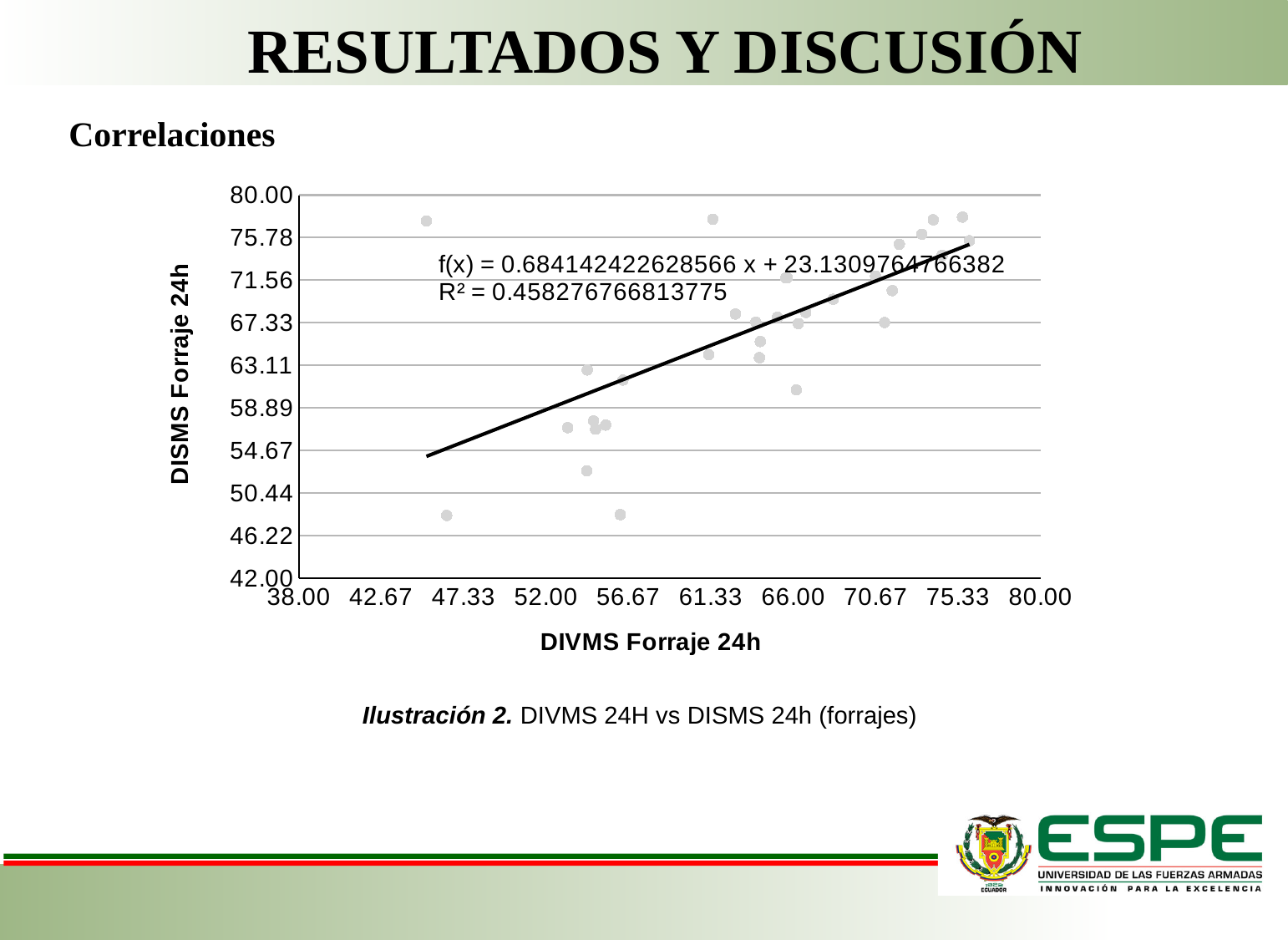
Does the trend line in the chart rise or fall as DIVMS Forraje 24h increases? Rises What is the highest value shown on the x axis? 80.00 What is the highest value shown on the y axis? 80.00 Is the slope of the trend line greater or less than 1? less What kind of chart is shown on the slide? Scatter chart Is the R² value of the trend line greater or less than 0.5? less What is the equation of the trend line printed on the chart? f(x) = 0.684142422628566 x + 23.1309764766382 What is the title of the x axis? DIVMS Forraje 24h What is the R² value printed on the chart? R² = 0.458276766813775 What is the lowest value shown on the x axis? 38.00 What is the title of the y axis? DISMS Forraje 24h What is the lowest value shown on the y axis? 42.00